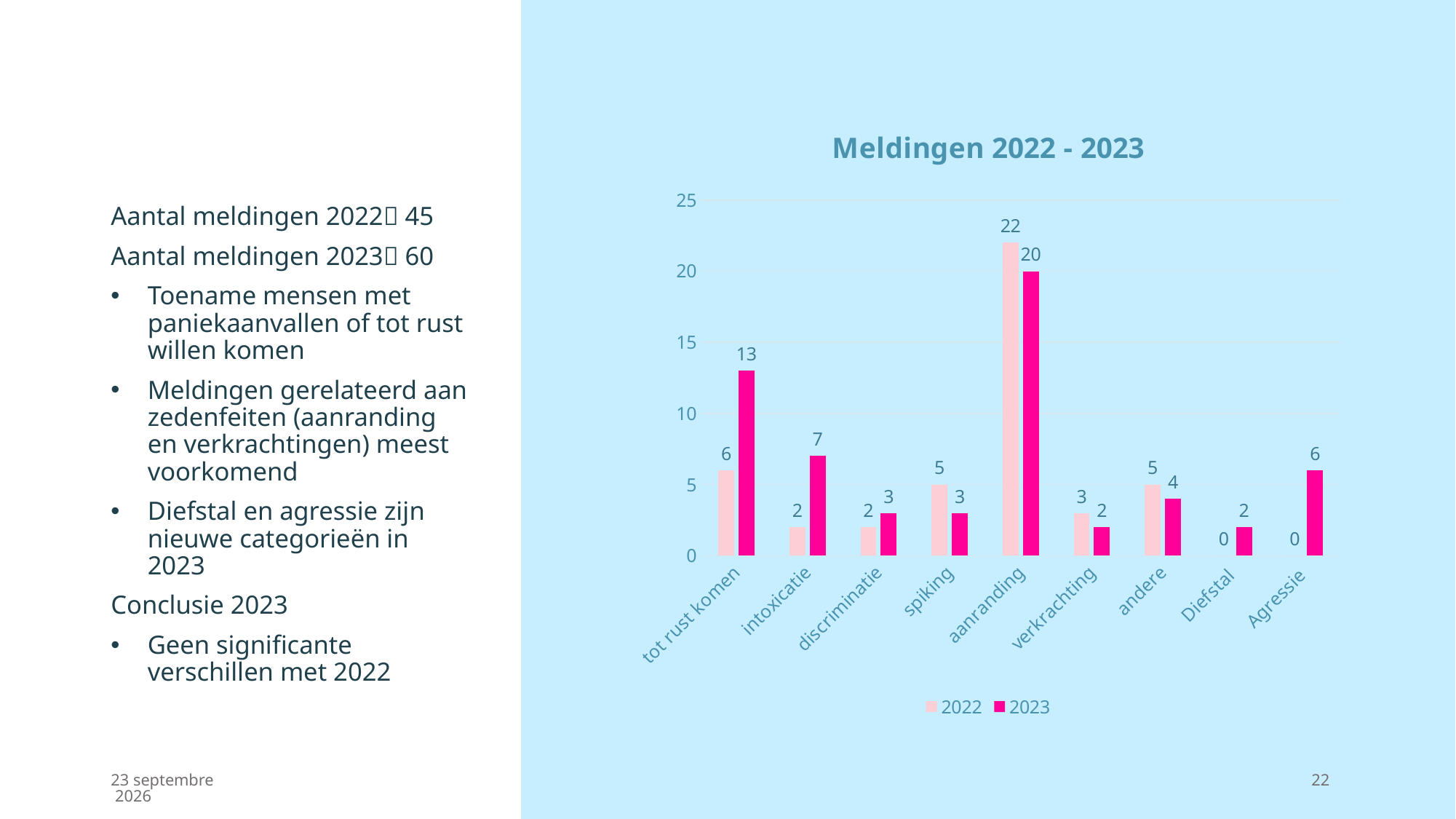
How many series does the legend list? 2 What is the value for 'tot rust komen' in the 2023 series? 13 What kind of chart is shown on the slide? bar chart What is the value for 'Agressie' in the 2023 series? 6 Which is larger for 'spiking': the 2022 value or the 2023 value? 2022 What is the title of the chart? Meldingen 2022 - 2023 What is the value for 'Diefstal' in the 2022 series? 0 Is the 2022 value for 'aanranding' greater or less than 20? greater Which category has the highest value in the 2023 series? aanranding How many categories are shown on the x axis? 9 What is the difference between the 2022 and 2023 values for 'tot rust komen'? 7 What is the value for 'aanranding' in the 2022 series? 22